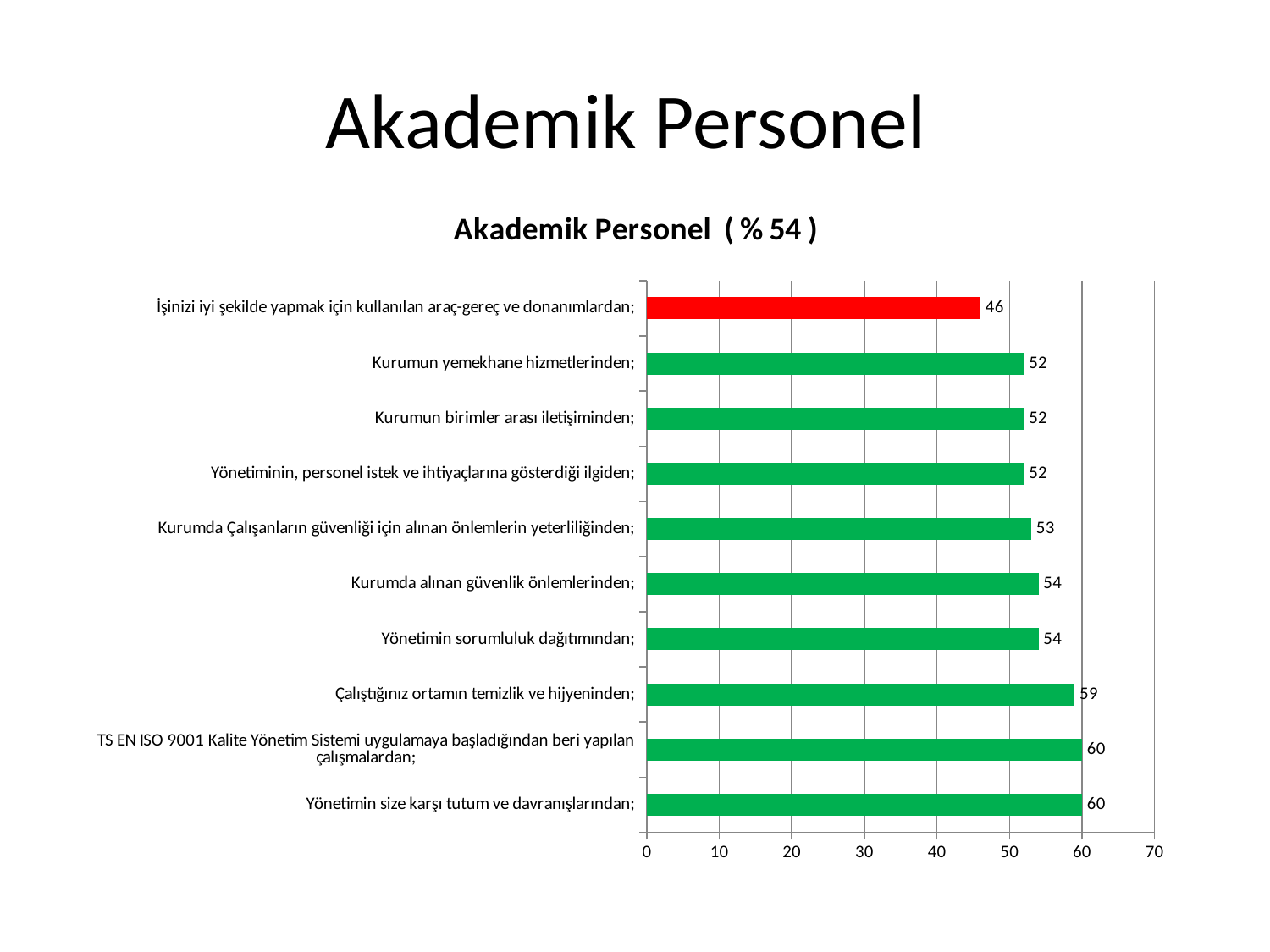
What is the title of the chart? Akademik Personel ( % 54 ) What is the value for "Kurumda Çalışanların güvenliği için alınan önlemlerin yeterliliğinden;"? 53 What is the value for "Kurumun yemekhane hizmetlerinden;"? 52 What is the value for "İşinizi iyi şekilde yapmak için kullanılan araç-gereç ve donanımlardan;"? 46 Which is larger: the value for "Çalıştığınız ortamın temizlik ve hijyeninden;" or the value for "Kurumda alınan güvenlik önlemlerinden;"? Çalıştığınız ortamın temizlik ve hijyeninden; What is the highest value shown in the chart? 60 Is the value for "Yönetimin sorumluluk dağıtımından;" greater or less than 50? greater How many categories are shown in the chart? 10 What is the difference between the values for "Yönetimin size karşı tutum ve davranışlarından;" and "İşinizi iyi şekilde yapmak için kullanılan araç-gereç ve donanımlardan;"? 14 What kind of chart is shown on the slide? bar chart What is the value for "Çalıştığınız ortamın temizlik ve hijyeninden;"? 59 Which category has the lowest value? İşinizi iyi şekilde yapmak için kullanılan araç-gereç ve donanımlardan;